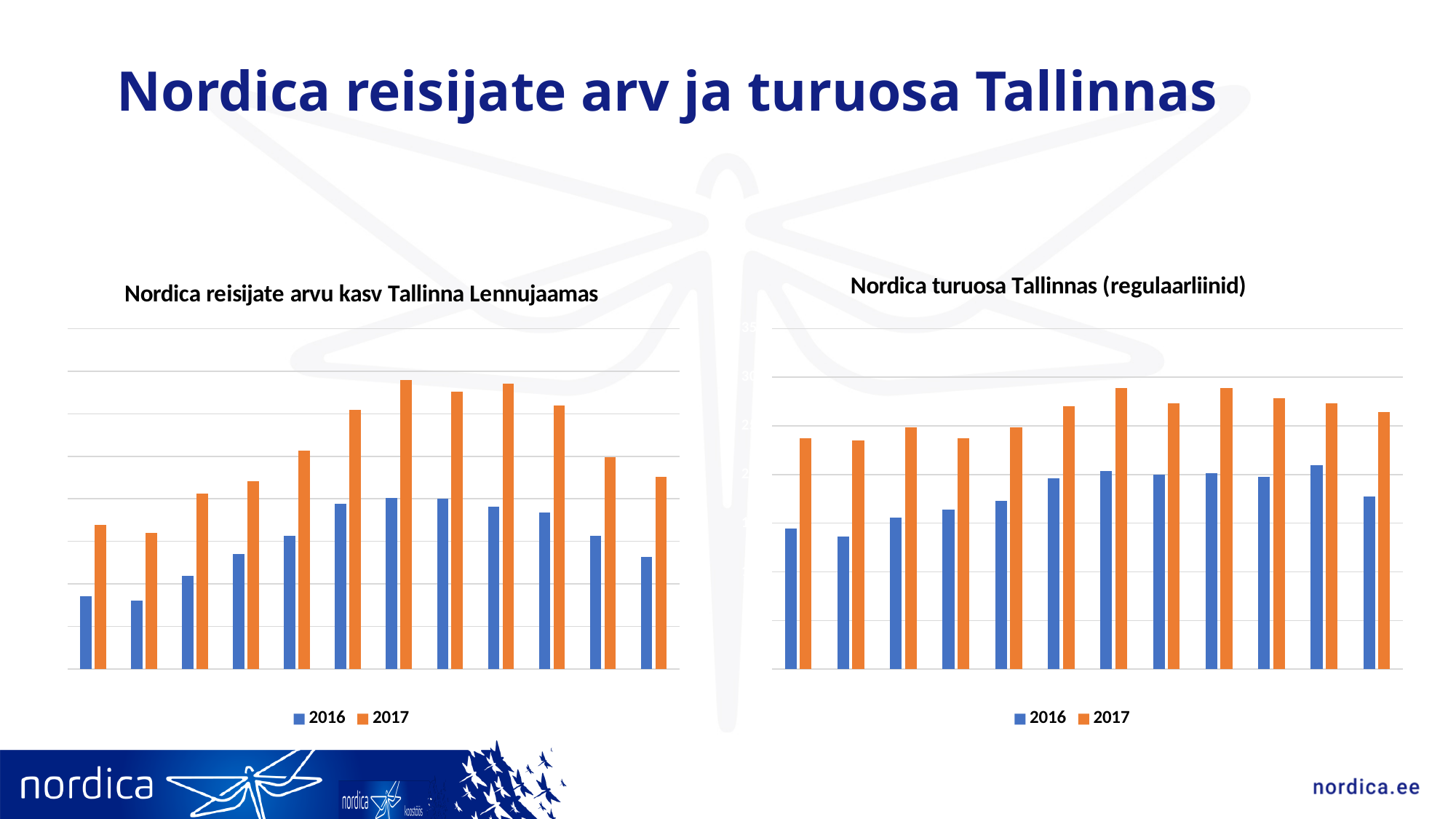
In the right chart, is any bar greater than 35? No What kind of chart is the left chart, 'Nordica reisijate arvu kasv Tallinna Lennujaamas'? bar chart What is the title of the left chart? Nordica reisijate arvu kasv Tallinna Lennujaamas How many series does the legend of the left chart list? 2 What kind of chart is the right chart, 'Nordica turuosa Tallinnas (regulaarliinid)'? bar chart How many groups of bars are plotted in the left chart? 12 In the left chart, which series has the higher bar in every group, 2016 or 2017? 2017 How many series does the legend of the right chart list? 2 In the right chart, is the highest 2017 bar greater or less than 30? less What are the two legend entries of the right chart? 2016 and 2017 In the right chart, which series has the higher bar in every group, 2016 or 2017? 2017 How many groups of bars are plotted in the right chart? 12